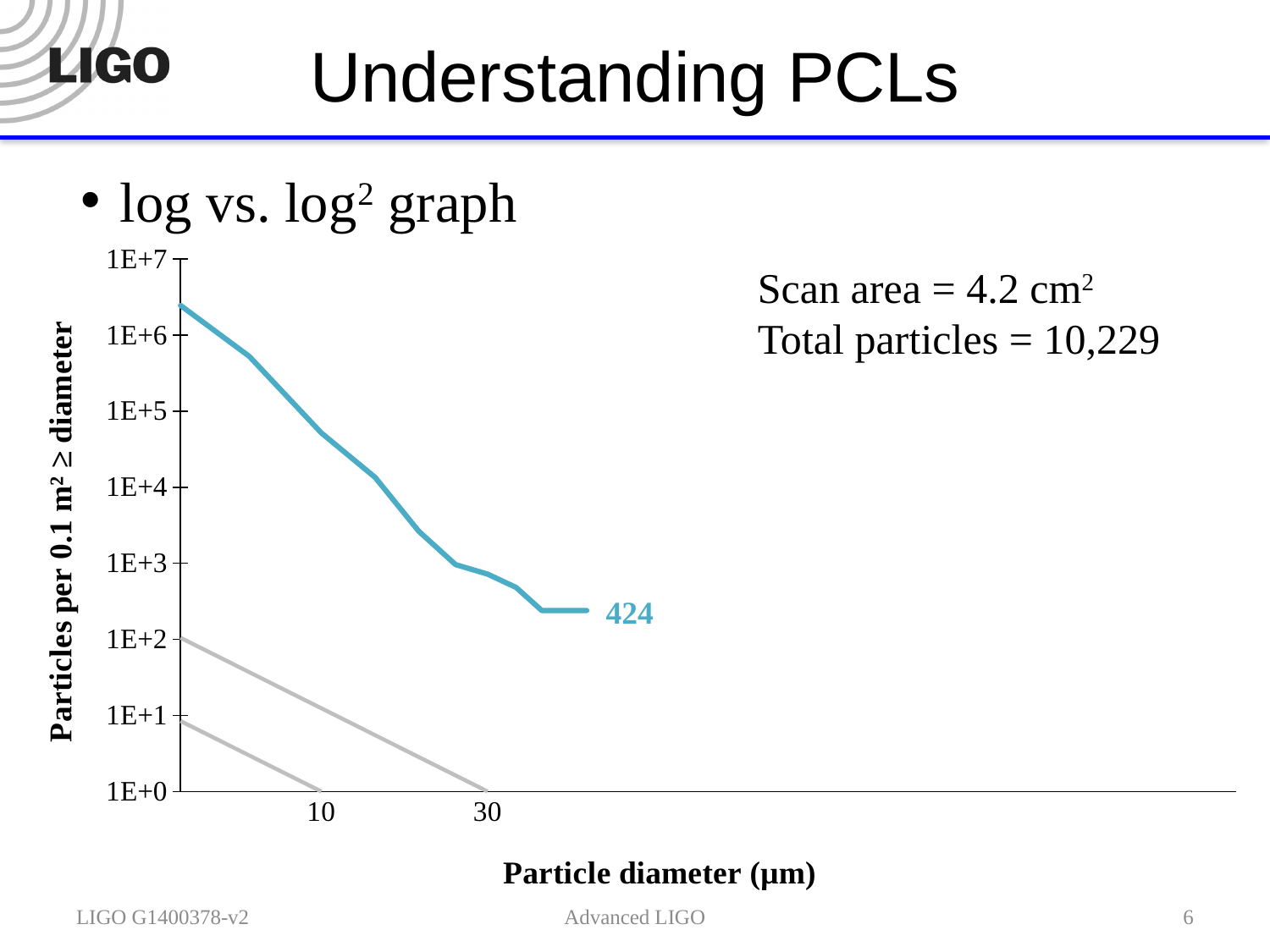
What is the title of the y axis? Particles per 0.1 m² ≥ diameter Is the value of the blue line at a particle diameter of 30 greater or less than 1E+4? less At a particle diameter of 10, which line has the higher value, the blue line or the upper gray line? the blue line Is the value of the blue line at a particle diameter of 30 greater or less than 1E+2? greater What value is printed as the data label at the right end of the blue line? 424 What is the title of the x axis? Particle diameter (µm) What kind of chart is shown on the slide? line chart What is the highest tick value shown on the y axis? 1E+7 At what particle diameter does the upper gray line reach 1E+0? 30 At what particle diameter does the lower gray line reach 1E+0? 10 Does the blue line rise or fall as particle diameter increases along the x axis? fall How many lines are plotted on the chart? 3